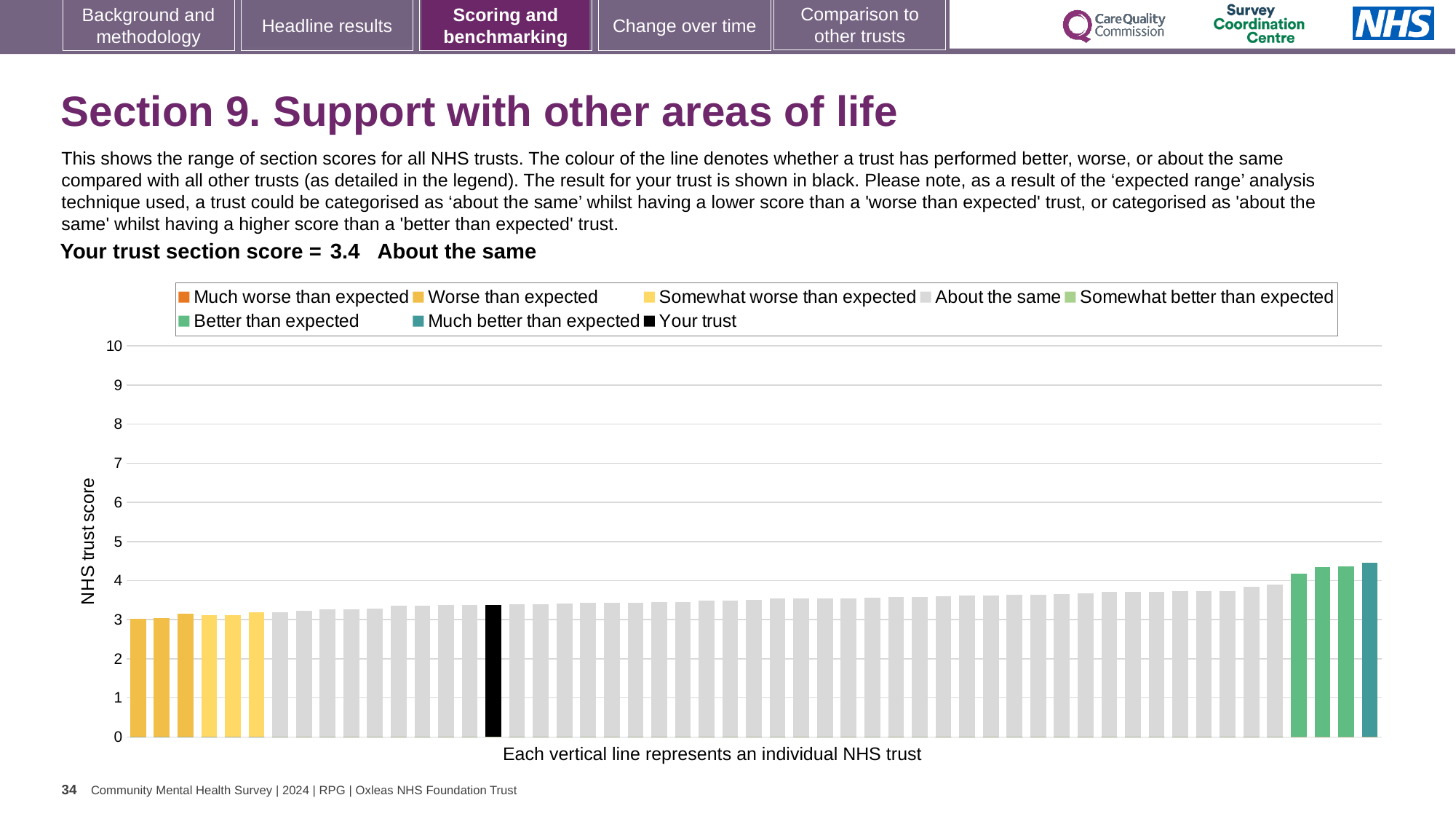
Do the bar values rise or fall from left to right along the x axis? rise What is the section score for your trust shown on the slide? 3.4 Is the value of the highest bar (the rightmost trust) greater or less than 4? greater Is the value for your trust (the black bar) greater or less than 4? less What kind of chart is shown on the slide? bar chart How many bars are coloured as 'Worse than expected' (the yellow bars on the left)? 3 Is the value for your trust (the black bar) greater or less than 2? greater What is the label on the vertical axis of the chart? NHS trust score How many bars are coloured as 'Much better than expected' (the teal bar on the right)? 1 How many entries does the chart legend list? 8 What colour is used for the bar representing your trust? black